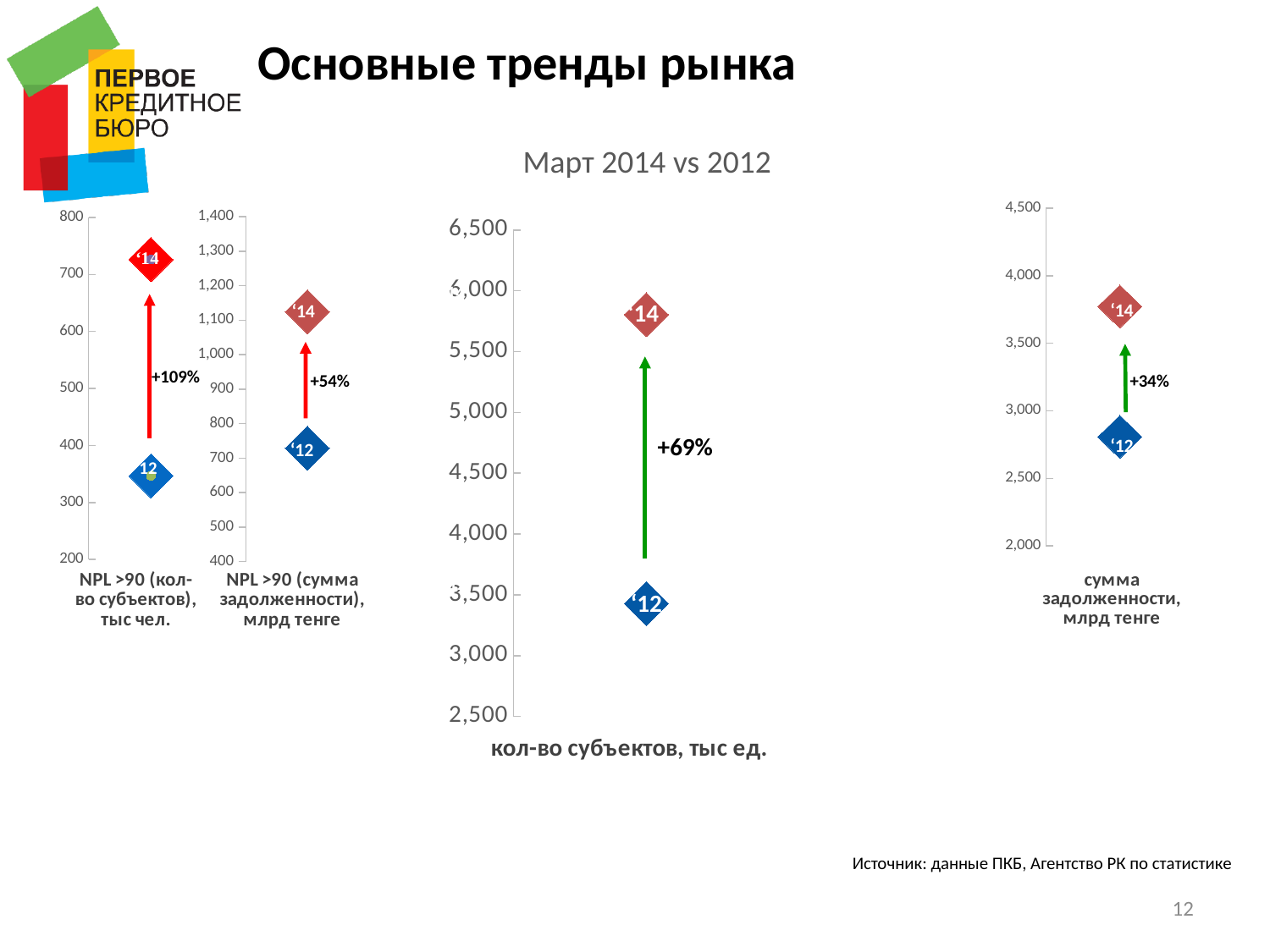
On the chart titled 'кол-во субъектов, тыс ед.', what percentage change is printed between '12 and '14? +69% On the chart titled 'NPL >90 (сумма задолженности), млрд тенге', do the values rise or fall from '12 to '14? rise What comparison period is stated in the subtitle above the charts? Март 2014 vs 2012 On the chart titled 'сумма задолженности, млрд тенге', is the value for '14 greater or less than 3,500? greater On the chart titled 'сумма задолженности, млрд тенге', what percentage change is printed between '12 and '14? +34% On the chart titled 'кол-во субъектов, тыс ед.', which is larger, the value for '12 or the value for '14? '14 On the chart titled 'NPL >90 (сумма задолженности), млрд тенге', what percentage change is printed between '12 and '14? +54% On the chart titled 'кол-во субъектов, тыс ед.', is the value for '12 greater or less than 4,000? less On the chart titled 'NPL >90 (сумма задолженности), млрд тенге', is the value for '12 greater or less than 800? less On the chart titled 'сумма задолженности, млрд тенге', how many data points are plotted? 2 On the chart titled 'NPL >90 (кол-во субъектов), тыс чел.', what percentage change is printed between '12 and '14? +109%